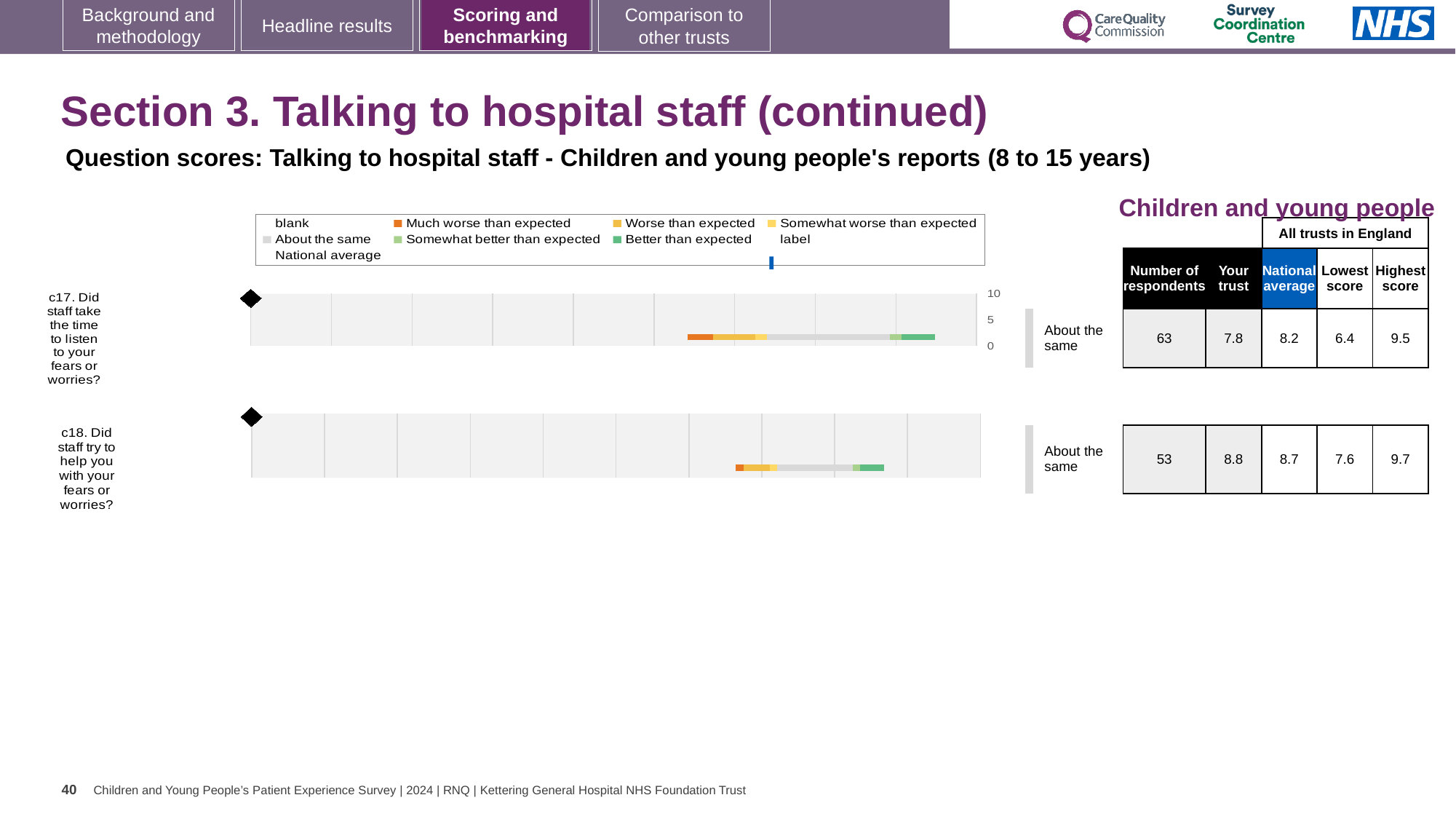
How many survey questions are plotted as charts on this slide? 2 For the c17 chart, what is the Highest score among all trusts in England? 9.5 For the c17 chart, what is the difference between the Highest score and the Lowest score? 3.1 What kind of chart is used for the c17 and c18 benchmarking displays? Bar chart In the c17 chart (Did staff take the time to listen to your fears or worries?), what is the score for Your trust? 7.8 For the c17 chart, how many respondents are shown? 63 In the c18 chart (Did staff try to help you with your fears or worries?), what is the National average score? 8.7 What benchmark category is shown next to the c17 chart? About the same In the c17 chart, is the Your trust score greater or less than 5? greater For the c18 chart, what is the difference between the Your trust score and the National average? 0.1 For the c18 chart, what is the Lowest score among all trusts in England? 7.6 Which question has the higher Your trust score, c17 or c18? c18